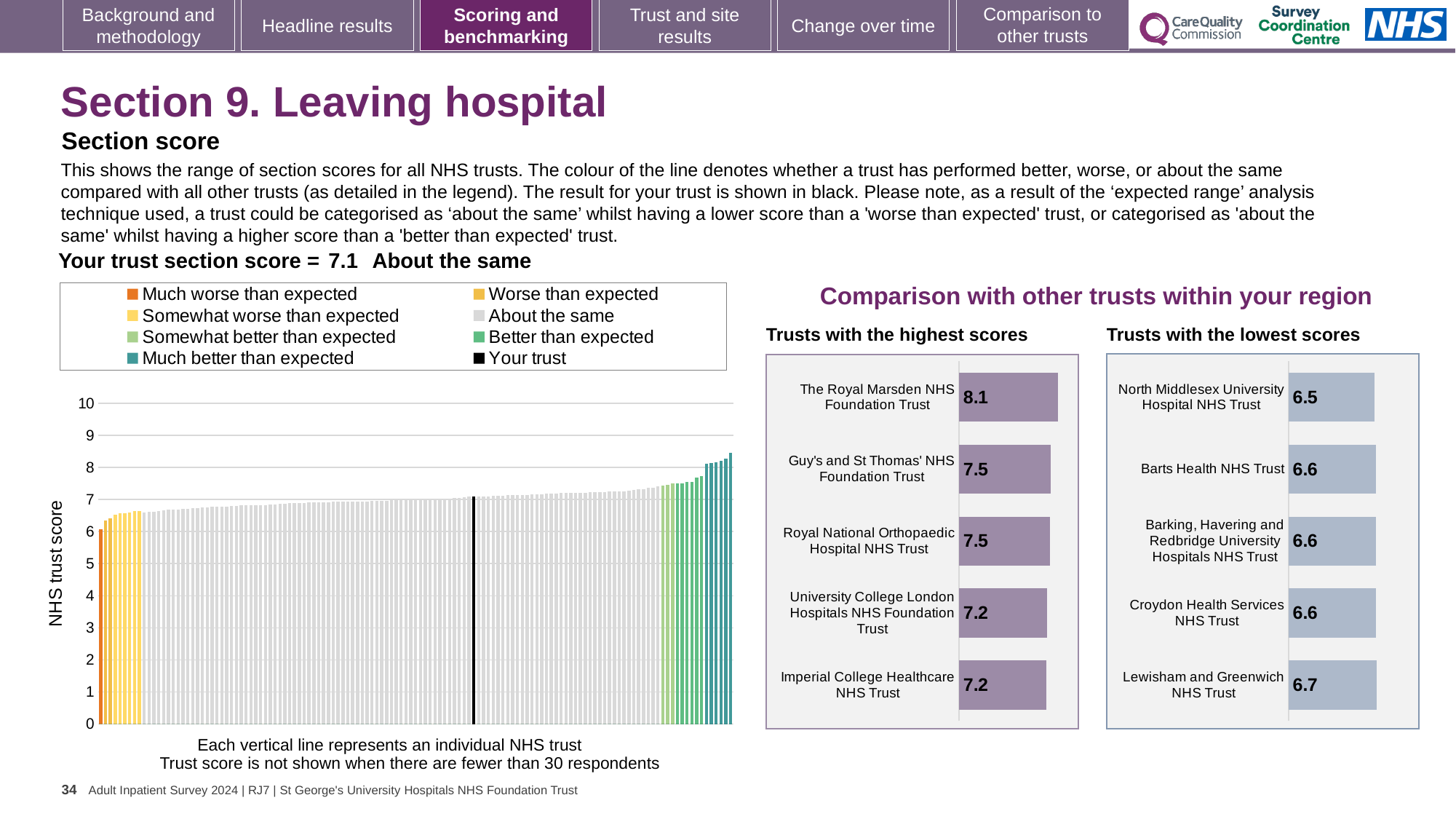
In the 'Trusts with the highest scores' chart, what is the score for The Royal Marsden NHS Foundation Trust? 8.1 In the 'Trusts with the lowest scores' chart, what is the score for Croydon Health Services NHS Trust? 6.6 In the 'Trusts with the lowest scores' chart, which trust has the highest score? Lewisham and Greenwich NHS Trust How many entries does the legend of the NHS trust score chart on the left list? 8 In the 'Trusts with the highest scores' chart, what is the difference between the scores of The Royal Marsden NHS Foundation Trust and Imperial College Healthcare NHS Trust? 0.9 In the NHS trust score chart on the left, what is the section score for your trust (the black line)? 7.1 In the 'Trusts with the lowest scores' chart, which trust has the lowest score? North Middlesex University Hospital NHS Trust In the NHS trust score chart on the left, is the value of the tallest bar greater or less than 8? greater How many trusts are shown in the 'Trusts with the lowest scores' chart? 5 In the 'Trusts with the highest scores' chart, which trust has the highest score? The Royal Marsden NHS Foundation Trust In the 'Trusts with the lowest scores' chart, what is the difference between the scores of Lewisham and Greenwich NHS Trust and North Middlesex University Hospital NHS Trust? 0.2 In the 'Trusts with the highest scores' chart, which has the larger score: The Royal Marsden NHS Foundation Trust or Guy's and St Thomas' NHS Foundation Trust? The Royal Marsden NHS Foundation Trust